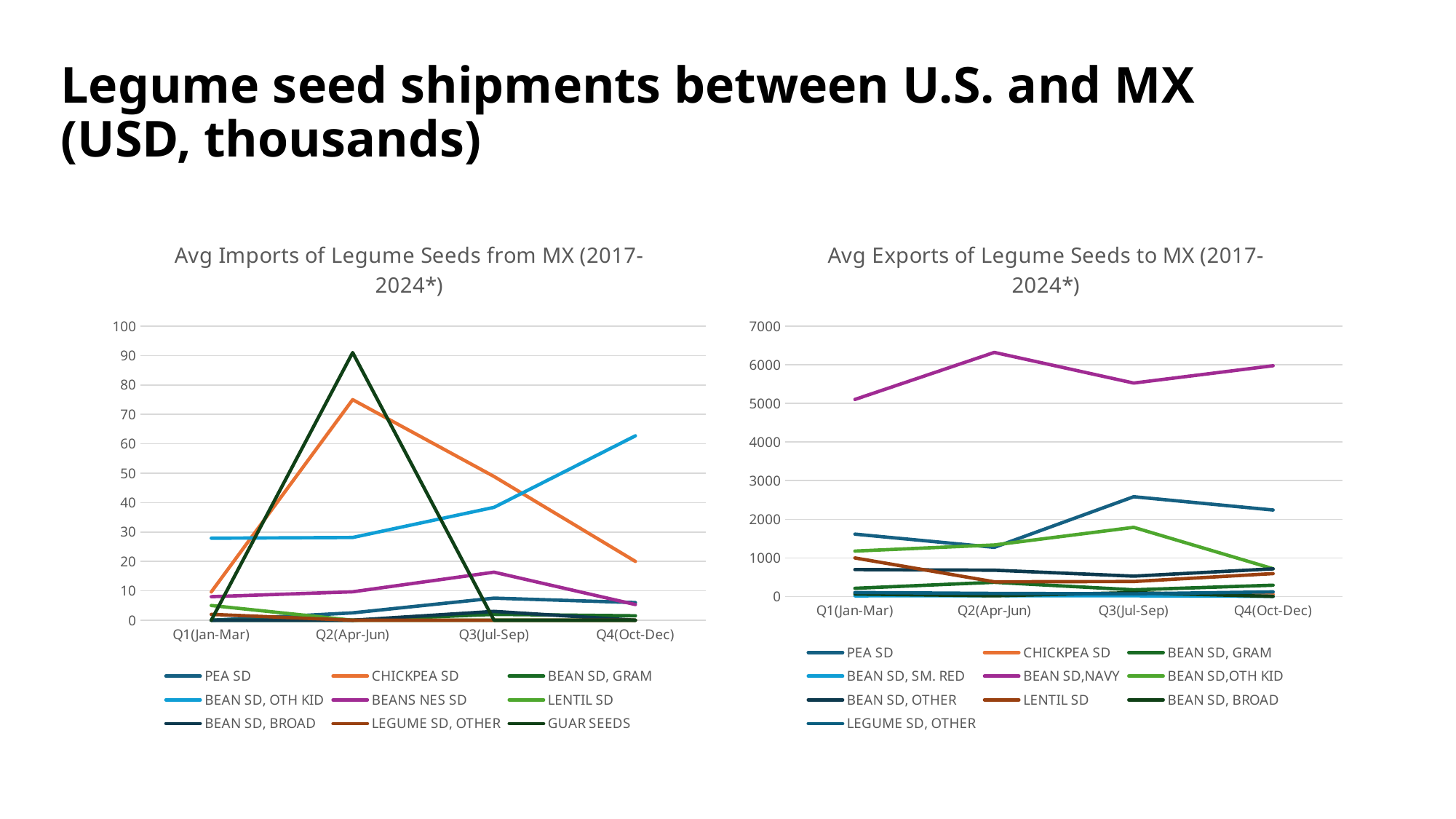
In the 'Avg Exports of Legume Seeds to MX (2017-2024*)' chart, is the value for PEA SD at Q3(Jul-Sep) greater or less than 2000? greater In the 'Avg Imports of Legume Seeds from MX (2017-2024*)' chart, is the value for GUAR SEEDS at Q2(Apr-Jun) greater or less than 80? greater In the 'Avg Imports of Legume Seeds from MX (2017-2024*)' chart, which series has the highest value at Q2(Apr-Jun)? GUAR SEEDS How many series does the legend of the 'Avg Exports of Legume Seeds to MX (2017-2024*)' chart list? 10 In the 'Avg Imports of Legume Seeds from MX (2017-2024*)' chart, does the BEAN SD, OTH KID line rise or fall from Q1(Jan-Mar) to Q4(Oct-Dec)? rise In the 'Avg Exports of Legume Seeds to MX (2017-2024*)' chart, is the value for BEAN SD,NAVY at Q2(Apr-Jun) greater or less than 6000? greater What kind of chart is the 'Avg Imports of Legume Seeds from MX (2017-2024*)' chart? Line chart How many quarters are shown on the x axis of the 'Avg Exports of Legume Seeds to MX (2017-2024*)' chart? 4 How many series does the legend of the 'Avg Imports of Legume Seeds from MX (2017-2024*)' chart list? 9 In the 'Avg Exports of Legume Seeds to MX (2017-2024*)' chart, which series has the highest values across all quarters? BEAN SD,NAVY